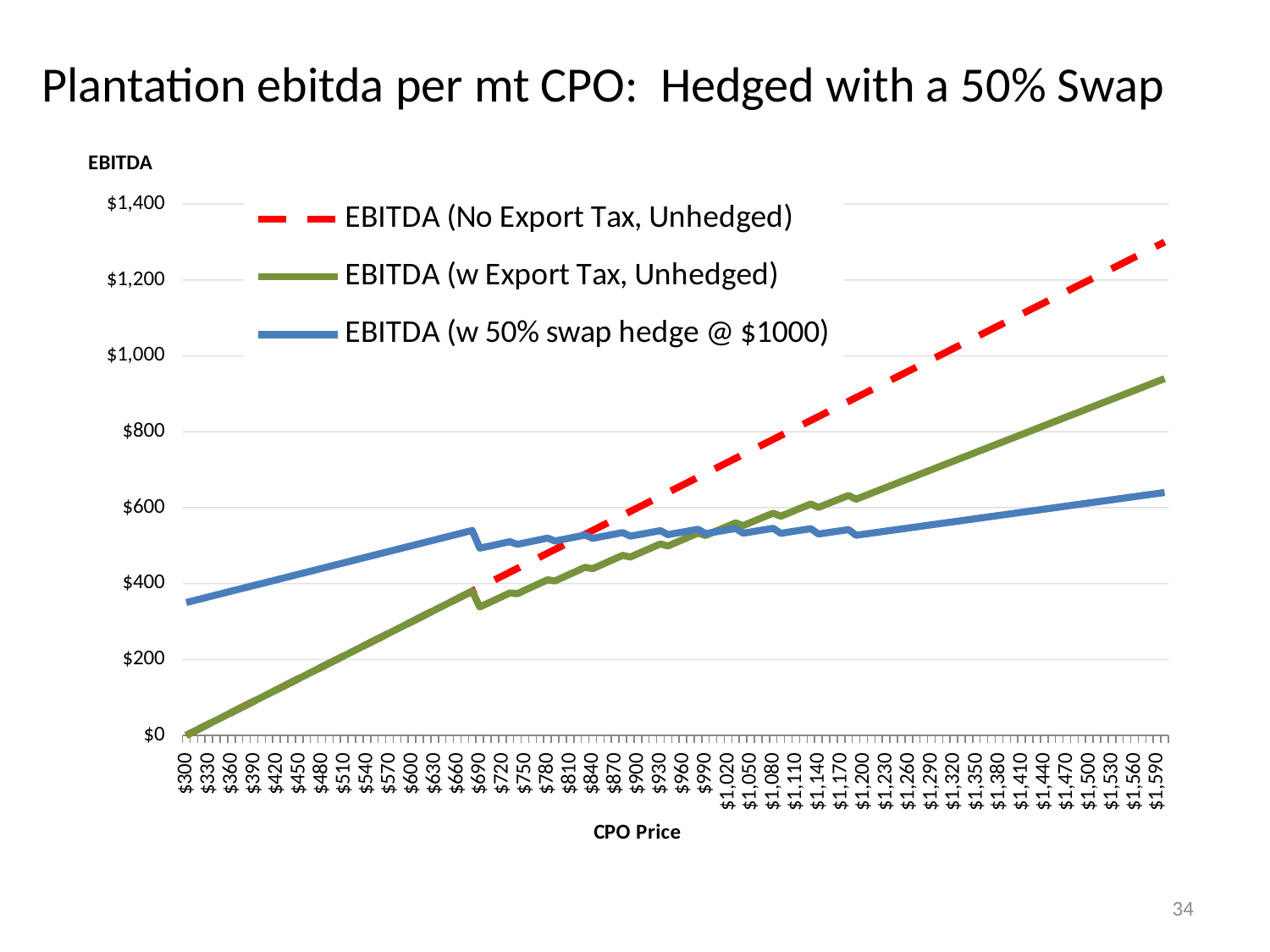
Is the value of EBITDA (w 50% swap hedge @ $1000) at a CPO price of $1,590 greater or less than $600? greater Which series has the highest value at a CPO price of $300? EBITDA (w 50% swap hedge @ $1000) Is the value of EBITDA (w 50% swap hedge @ $1000) at a CPO price of $300 greater or less than $200? greater Which series has the highest value at a CPO price of $1,590? EBITDA (No Export Tax, Unhedged) Is the value of EBITDA (No Export Tax, Unhedged) at a CPO price of $1,590 greater or less than $1,200? greater What type of chart is shown on the slide? line chart At a CPO price of $600, which is larger: EBITDA (w 50% swap hedge @ $1000) or EBITDA (w Export Tax, Unhedged)? EBITDA (w 50% swap hedge @ $1000) Does EBITDA (No Export Tax, Unhedged) rise or fall as the CPO price increases along the x axis? rise How many series does the legend list? 3 What is the title of the slide's chart? Plantation ebitda per mt CPO: Hedged with a 50% Swap Which series is drawn as a red dashed line? EBITDA (No Export Tax, Unhedged)